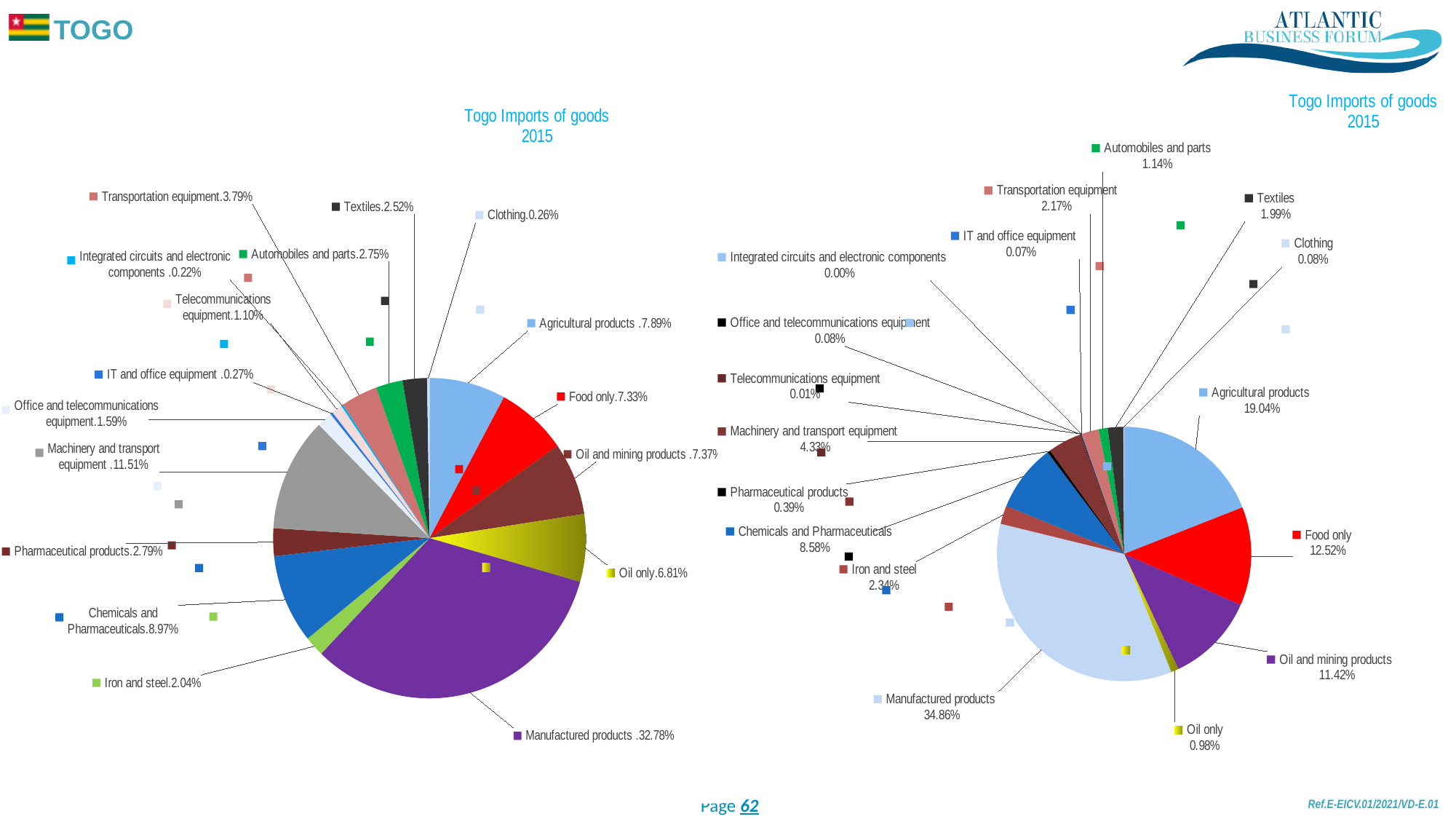
On the left pie chart, what is the share for Machinery and transport equipment? 11.51% On the left pie chart, what is the share for Manufactured products? 32.78% On the left pie chart, which category has the largest share? Manufactured products On the left pie chart, which category has the smallest share? Integrated circuits and electronic components What type of chart is used on the right side of the slide? Pie chart On the right pie chart, what is the share for Food only? 12.52% On the right pie chart, which category has the smallest share? Integrated circuits and electronic components On the left pie chart, which is larger: Chemicals and Pharmaceuticals or Agricultural products? Chemicals and Pharmaceuticals On the right pie chart, what is the share for Agricultural products? 19.04% On the right pie chart, what is the difference between the shares of Manufactured products and Agricultural products? 15.82% How many categories are shown on the left pie chart? 17 On the right pie chart, which is larger: Oil and mining products or Oil only? Oil and mining products